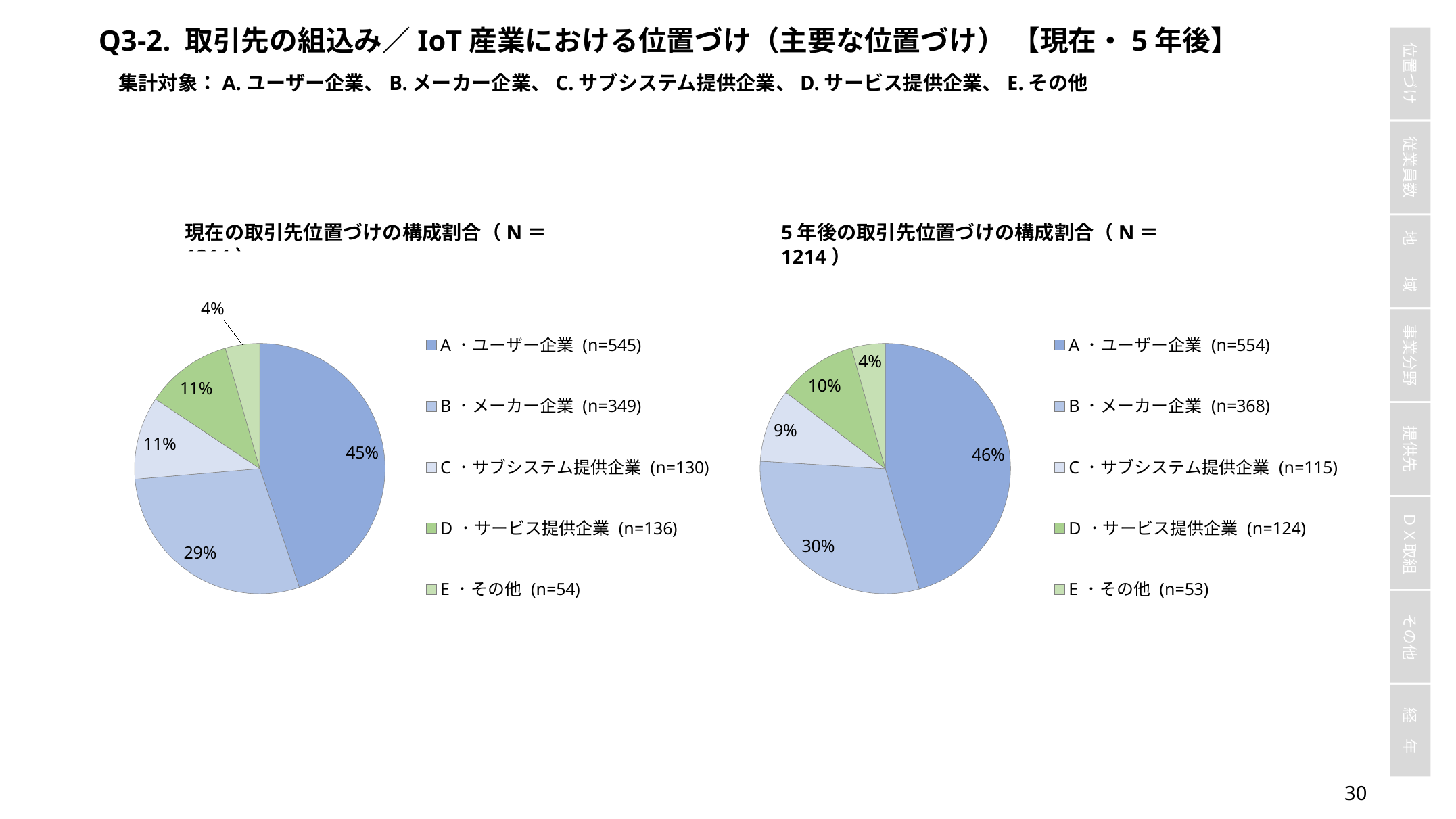
In the right pie chart (5年後), which is larger: the share of C・サブシステム提供企業 or D・サービス提供企業? D・サービス提供企業 In the right pie chart (5年後), what is the difference in percentage points between A・ユーザー企業 and B・メーカー企業? 16 What type of chart is used on this slide? Pie chart In the right pie chart (5年後), what share does C・サブシステム提供企業 have? 9% In the left pie chart (現在), which category has the largest share? A・ユーザー企業 In the right pie chart (5年後の取引先位置づけの構成割合), what share does B・メーカー企業 have? 30% How many slices does the left pie chart (現在) have? 5 In the left pie chart (現在), what share does E・その他 have? 4% In the right pie chart (5年後), which category has the smallest share? E・その他 In the left pie chart (現在), what is the n value shown in the legend for B・メーカー企業? n=349 In the right pie chart (5年後), what is the n value shown in the legend for D・サービス提供企業? n=124